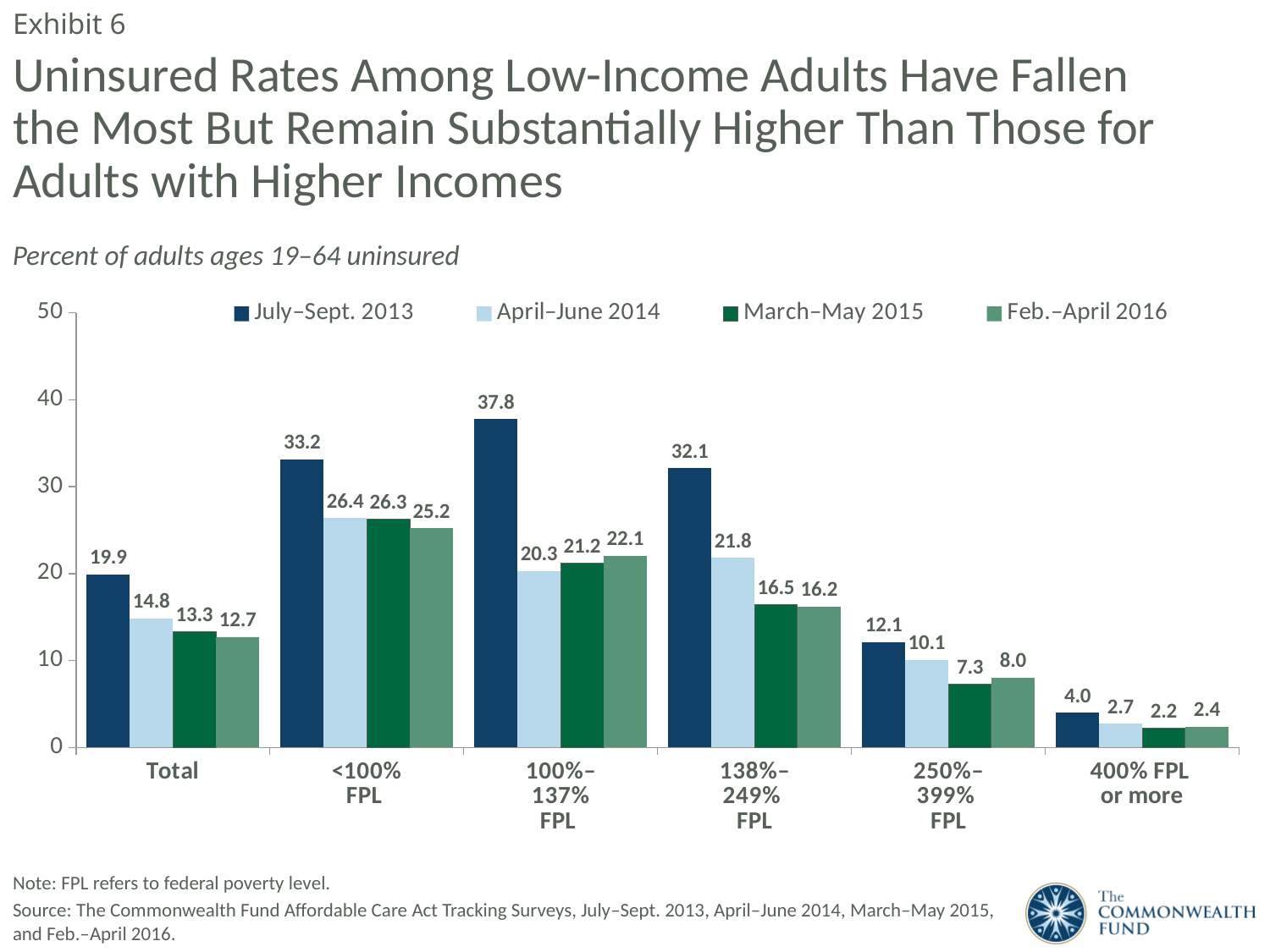
What is the difference between the July–Sept. 2013 and Feb.–April 2016 uninsured rates for adults at <100% FPL? 8.0 How many survey periods does the legend list? 4 Is the July–Sept. 2013 uninsured rate for adults at 138%–249% FPL greater or less than 30? greater For adults at 250%–399% FPL, which is larger: the March–May 2015 rate or the Feb.–April 2016 rate? Feb.–April 2016 Which income group has the highest uninsured rate in July–Sept. 2013? 100%–137% FPL Does the uninsured rate for the Total group rise or fall from July–Sept. 2013 to Feb.–April 2016? Fall What is the uninsured rate for the Total group in July–Sept. 2013? 19.9 What type of chart is shown on the slide? Bar chart How many income categories are shown on the x axis? 6 Which income group has the lowest uninsured rate in Feb.–April 2016? 400% FPL or more What is the uninsured rate for adults at 400% FPL or more in March–May 2015? 2.2 What is the uninsured rate for adults at 100%–137% FPL in Feb.–April 2016? 22.1